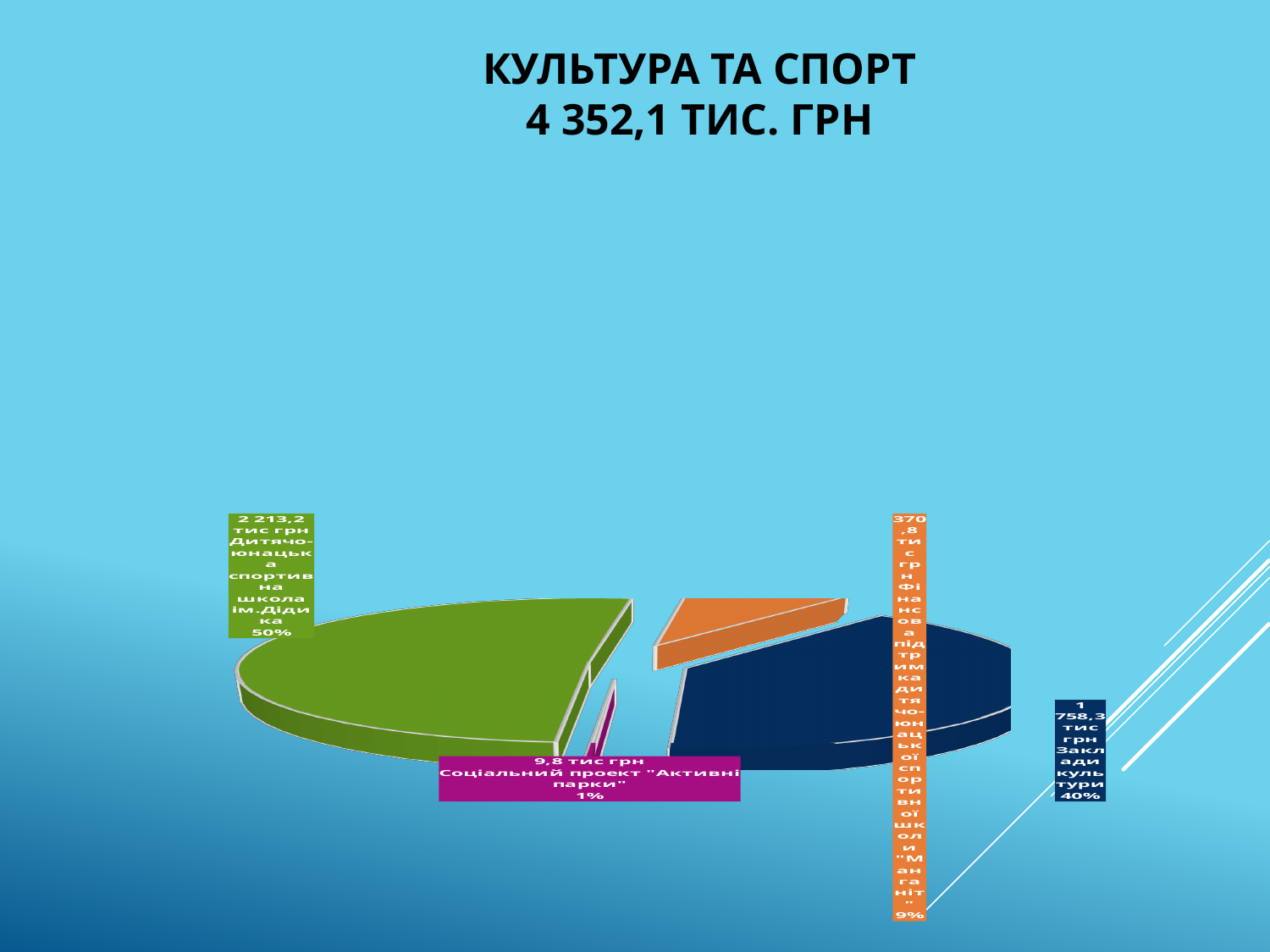
What total amount is stated in the chart title? 4 352,1 тис. грн What is the value shown for Заклади культури? 1 758,3 тис грн What is the value shown for Соціальний проект "Активні парки"? 9,8 тис грн Which is larger: Заклади культури or Фінансова підтримка дитячо-юнацької спортивної школи "Манганіт"? Заклади культури What share of the pie does Фінансова підтримка дитячо-юнацької спортивної школи "Манганіт" represent? 9% What is the difference between the values for Дитячо-юнацька спортивна школа ім.Дідика and Заклади культури? 454,9 тис грн Which category has the largest slice of the pie? Дитячо-юнацька спортивна школа ім.Дідика What share of the pie does Заклади культури represent? 40% Which category has the smallest slice of the pie? Соціальний проект "Активні парки" How many slices does the pie chart have? 4 What kind of chart is shown on the slide? pie chart What is the value shown for Дитячо-юнацька спортивна школа ім.Дідика? 2 213,2 тис грн